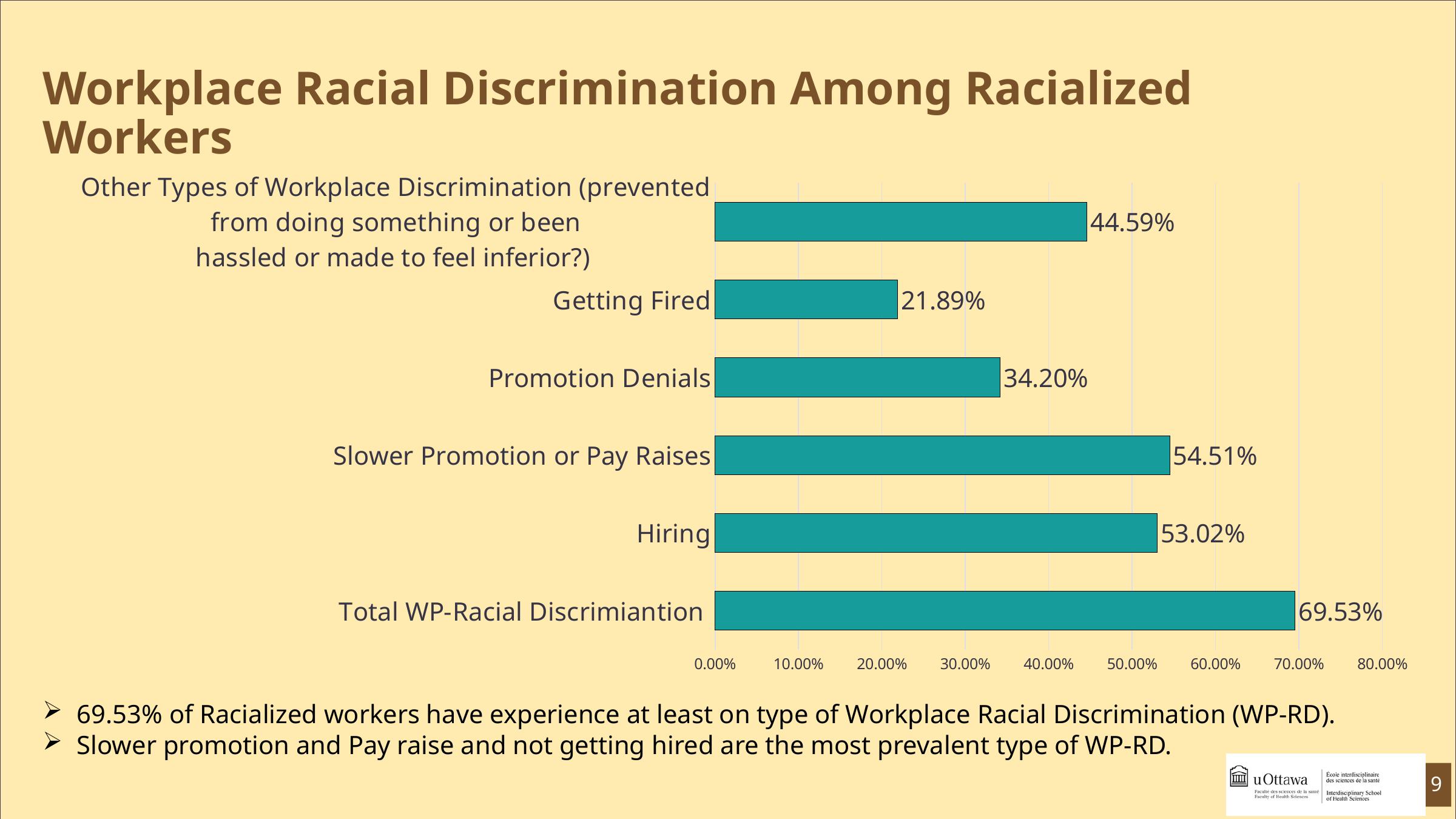
What is the value for Promotion Denials? 34.20% Which category has the lowest value? Getting Fired What kind of chart is shown on the slide? bar chart Which is larger, the value for Promotion Denials or the value for Getting Fired? Promotion Denials What is the value for Getting Fired? 21.89% What is the value for Slower Promotion or Pay Raises? 54.51% Which category has the highest value? Total WP-Racial Discrimiantion What is the value for Hiring? 53.02% What is the difference between the values for Slower Promotion or Pay Raises and Hiring? 1.49% Is the value for Total WP-Racial Discrimiantion greater or less than 60.00%? greater What is the difference between the values for Promotion Denials and Getting Fired? 12.31% How many categories are shown in the chart? 6